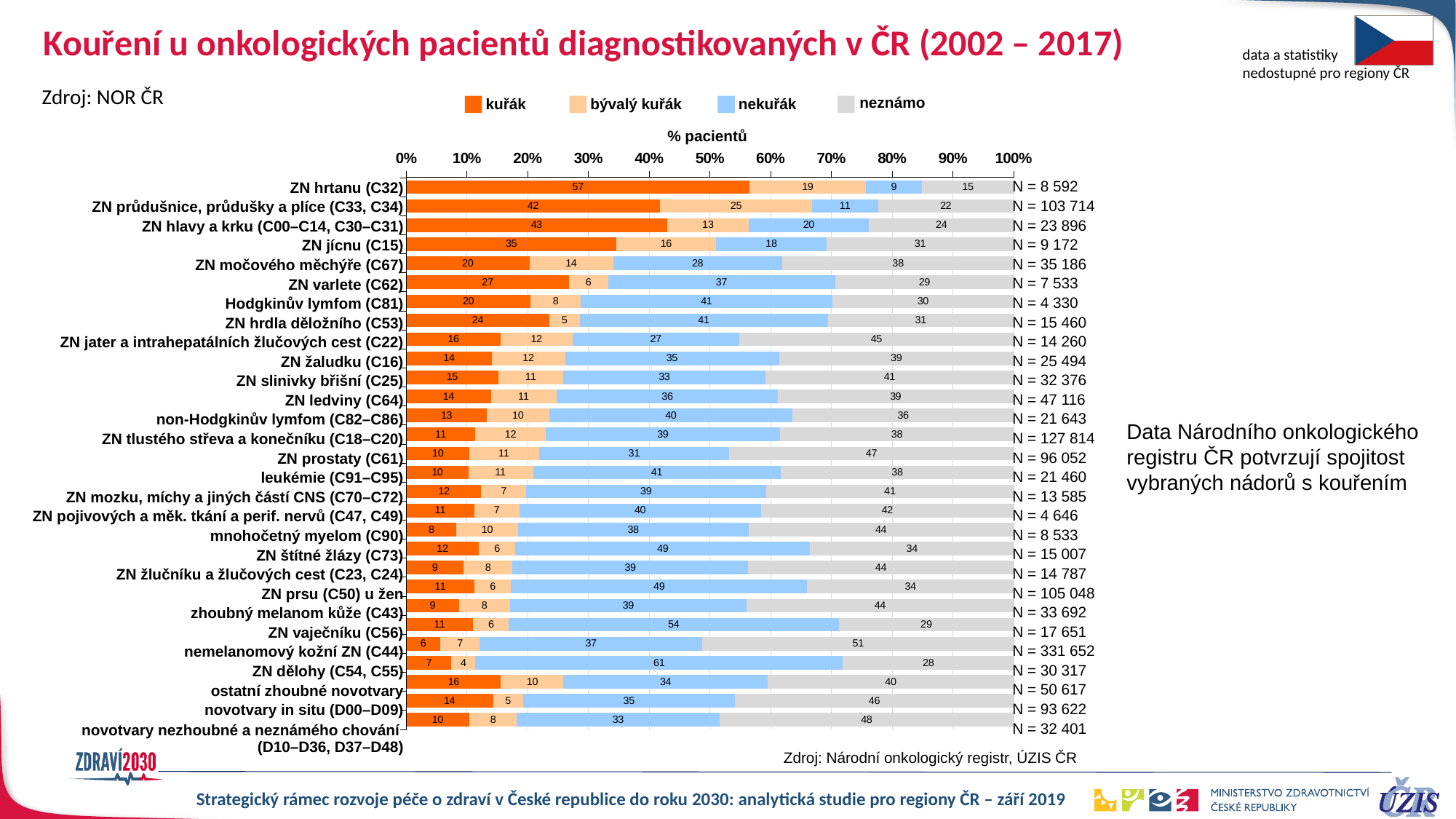
What are the four legend entries of the chart? kuřák, bývalý kuřák, nekuřák, neznámo What kind of chart is shown on the slide? Stacked bar chart Which diagnosis has the lowest kuřák percentage? nemelanomový kožní ZN (C44) What is the N value shown for ZN průdušnice, průdušky a plíce (C33, C34)? N = 103 714 Which diagnosis has the highest kuřák percentage? ZN hrtanu (C32) How many series does the legend list? 4 Which has a larger nekuřák value: ZN vaječníku (C56) or ZN prsu (C50) u žen? ZN vaječníku (C56) What is the neznámo value for nemelanomový kožní ZN (C44)? 51 What percentage of patients with ZN hrtanu (C32) are labelled kuřák? 57 What is the difference between the kuřák values for ZN hrtanu (C32) and ZN průdušnice, průdušky a plíce (C33, C34)? 15 What is the total of the four segments for ZN hrtanu (C32)? 100 What is the nekuřák value for ZN dělohy (C54, C55)? 61